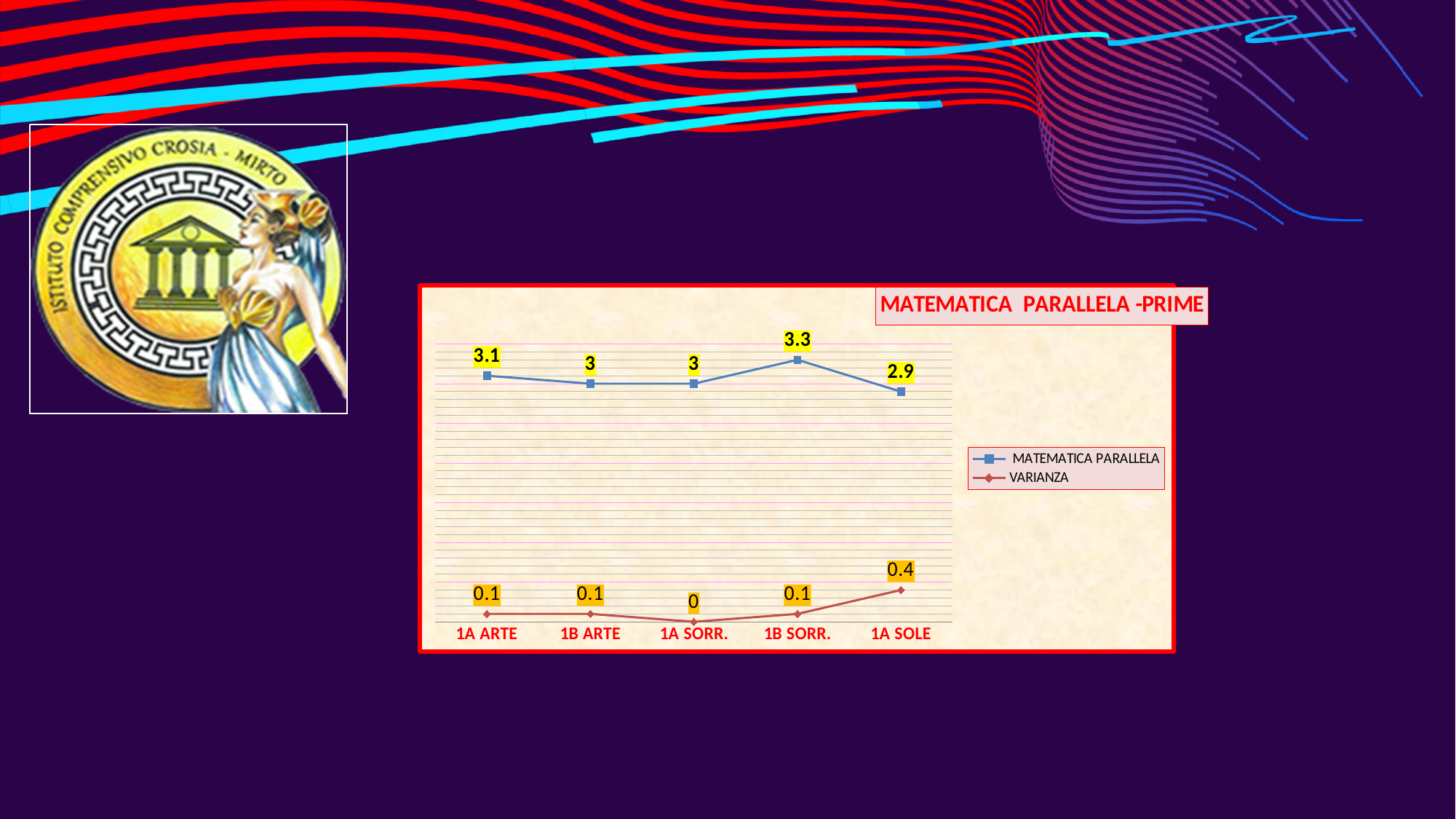
Which is larger, the MATEMATICA PARALLELA value for 1A ARTE or for 1B ARTE? 1A ARTE What is the difference between the MATEMATICA PARALLELA values for 1B SORR. and 1A SOLE? 0.4 Which category has the highest MATEMATICA PARALLELA value? 1B SORR. How many series does the legend list? 2 How many categories are shown on the x axis? 5 What is the title of the chart? MATEMATICA PARALLELA -PRIME Which category has the lowest VARIANZA value? 1A SORR. What kind of chart is shown? Line chart What is the MATEMATICA PARALLELA value for 1A SOLE? 2.9 Which category has the lowest MATEMATICA PARALLELA value? 1A SOLE What is the MATEMATICA PARALLELA value for 1B SORR.? 3.3 What is the VARIANZA value for 1A SOLE? 0.4